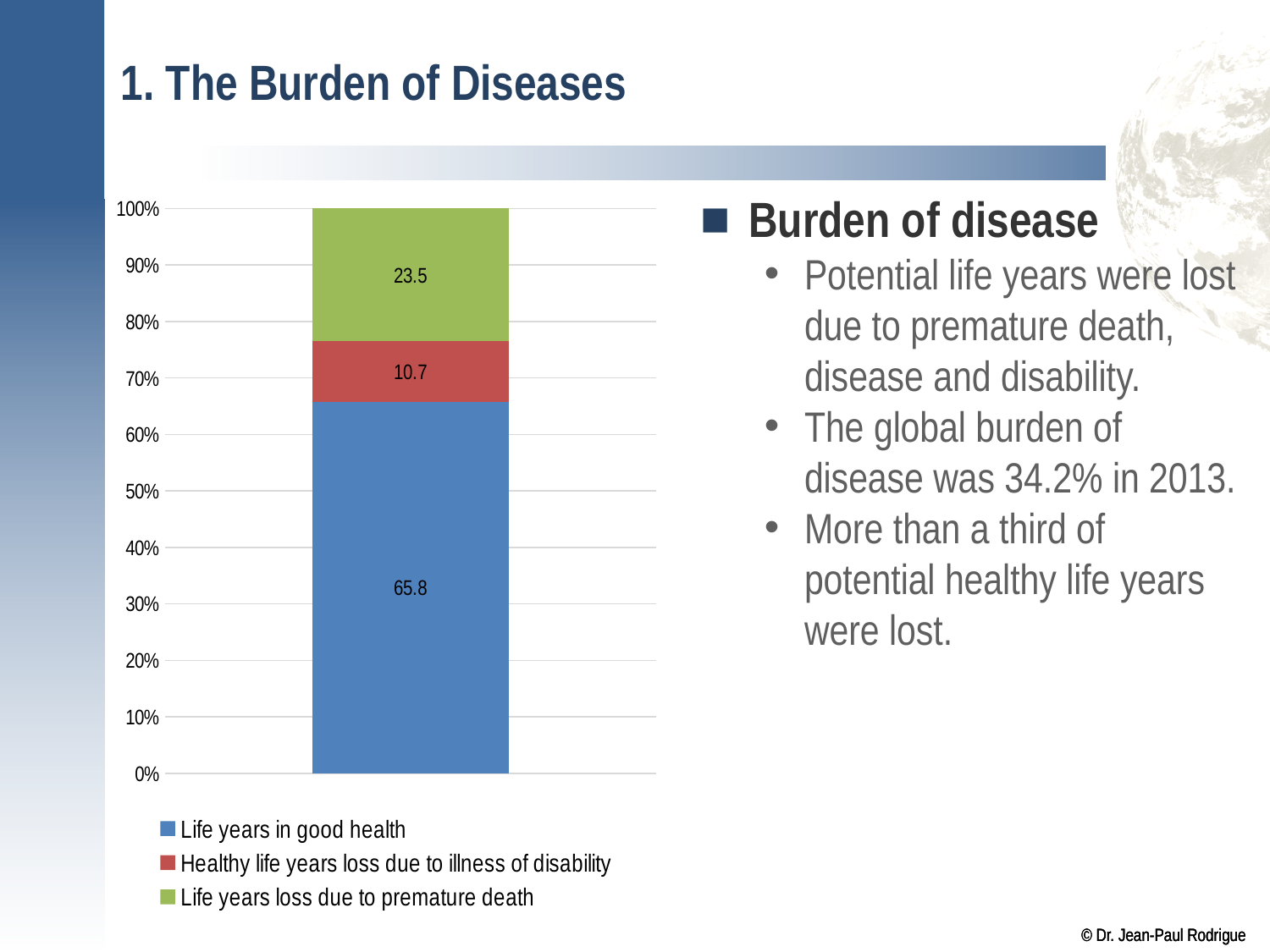
Which is larger: the 'Life years loss due to premature death' segment or the 'Healthy life years loss due to illness of disability' segment? Life years loss due to premature death How many series does the legend list? 3 Which series has the smallest segment in the stacked bar? Healthy life years loss due to illness of disability What value is shown for the 'Life years loss due to premature death' segment? 23.5 What is the difference between the 'Life years in good health' value and the 'Life years loss due to premature death' value? 42.3 What is the difference between the 'Life years loss due to premature death' value and the 'Healthy life years loss due to illness of disability' value? 12.8 What value is shown for the 'Life years in good health' segment of the stacked bar? 65.8 Which series has the largest segment in the stacked bar? Life years in good health What kind of chart is shown on the slide? Stacked bar chart What is the total of the three segments in the stacked bar? 100 What value is shown for the 'Healthy life years loss due to illness of disability' segment? 10.7 What colour is used for the 'Life years loss due to premature death' series? Green